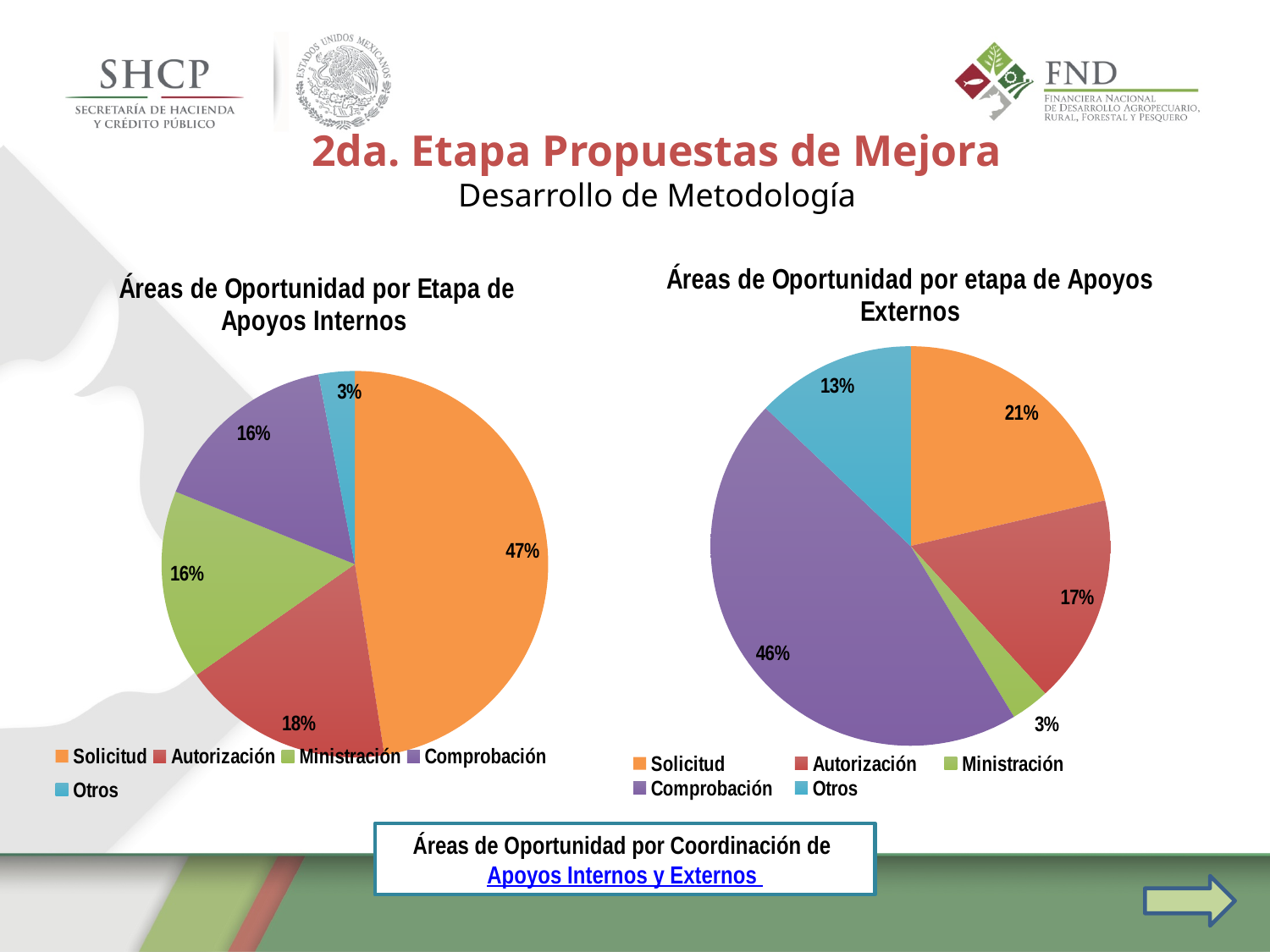
In the 'Áreas de Oportunidad por Etapa de Apoyos Internos' chart, what is the difference between Solicitud and Autorización? 29% In the 'Áreas de Oportunidad por Etapa de Apoyos Internos' chart, what is the value for Autorización? 18% In the 'Áreas de Oportunidad por Etapa de Apoyos Internos' chart, what share does Solicitud have? 47% In the 'Áreas de Oportunidad por etapa de Apoyos Externos' chart, which is larger, Solicitud or Autorización? Solicitud In the 'Áreas de Oportunidad por Etapa de Apoyos Internos' chart, which category has the smallest slice? Otros In the 'Áreas de Oportunidad por etapa de Apoyos Externos' chart, what share does Comprobación have? 46% In the 'Áreas de Oportunidad por etapa de Apoyos Externos' chart, which category has the largest slice? Comprobación In the 'Áreas de Oportunidad por etapa de Apoyos Externos' chart, which category has the smallest slice? Ministración In the 'Áreas de Oportunidad por etapa de Apoyos Externos' chart, what is the difference between Comprobación and Solicitud? 25% How many categories does the legend of the 'Áreas de Oportunidad por Etapa de Apoyos Internos' chart list? 5 What type of chart is 'Áreas de Oportunidad por etapa de Apoyos Externos'? Pie chart In the 'Áreas de Oportunidad por etapa de Apoyos Externos' chart, what is the value for Otros? 13%